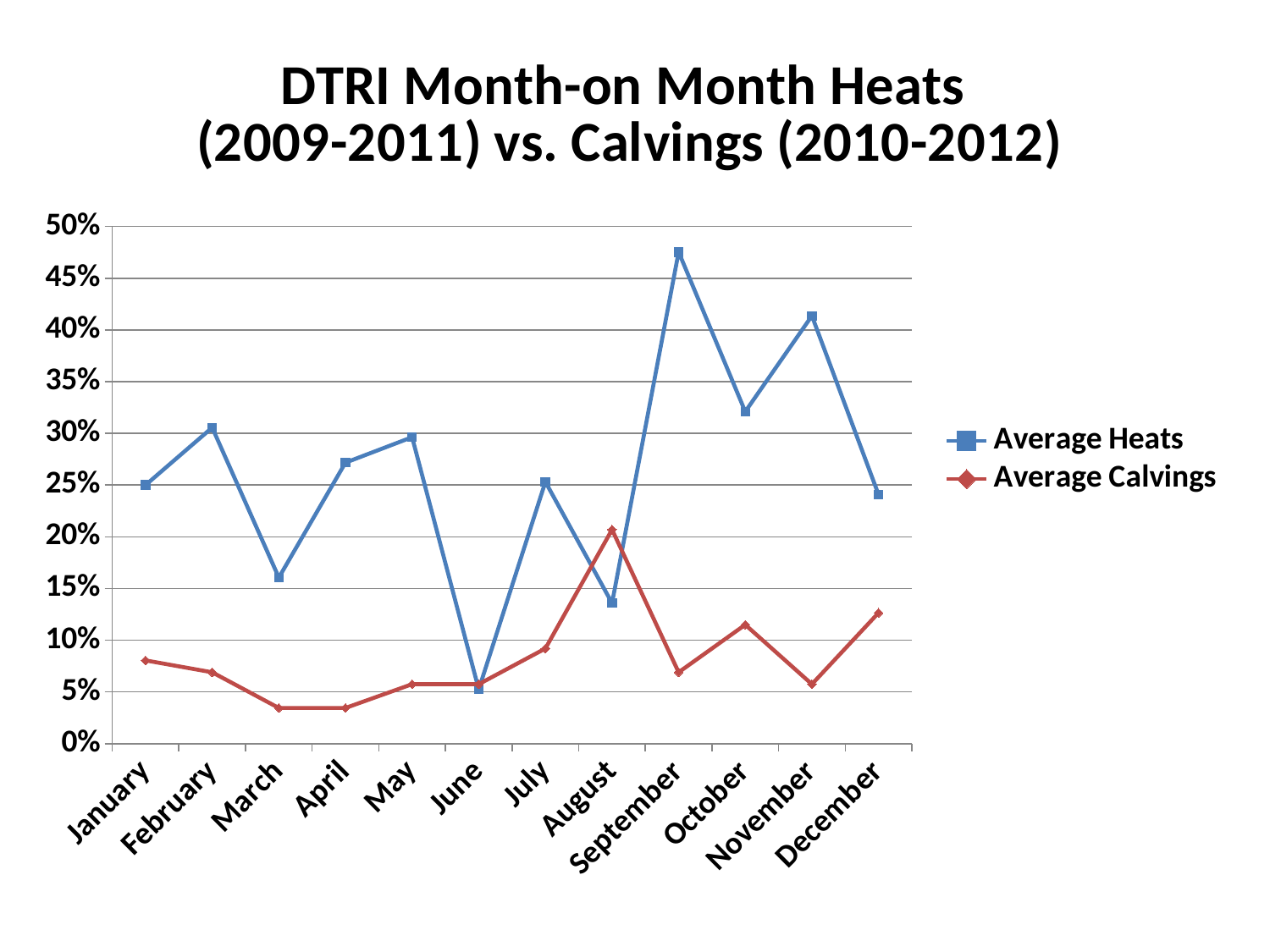
How many months are plotted along the x axis? 12 Is the Average Heats value for June greater or less than 10%? less What colour is the Average Calvings line? red What kind of chart is shown on the slide? line chart In which month is Average Heats highest? September In which month is Average Calvings highest? August How many series does the legend list? 2 Is the Average Calvings value for August greater or less than 15%? greater In which month is Average Heats lowest? June Is the Average Heats value for September greater or less than 45%? greater Does Average Calvings rise or fall from January to March? fall Which series has the larger value in September, Average Heats or Average Calvings? Average Heats